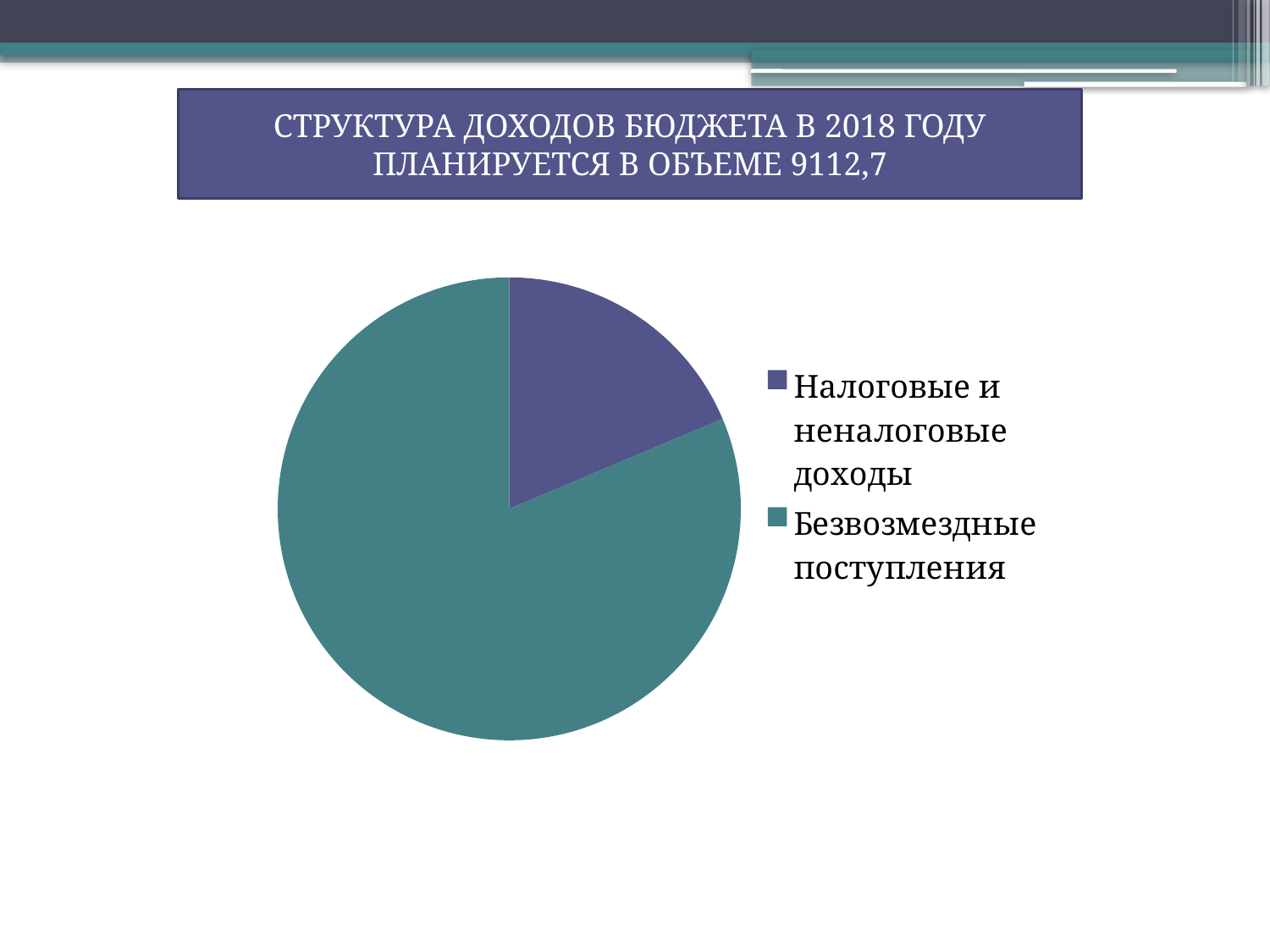
How many entries does the legend list? 2 Which category has the smallest slice of the pie? Налоговые и неналоговые доходы What kind of chart is shown on the slide? Pie chart How many slices does the pie chart have? 2 Which category has the largest slice of the pie? Безвозмездные поступления What total planned budget revenue volume for 2018 is stated in the slide title? 9112,7 Which is larger: the slice for Налоговые и неналоговые доходы or the slice for Безвозмездные поступления? Безвозмездные поступления What colour is the slice for Безвозмездные поступления? Teal